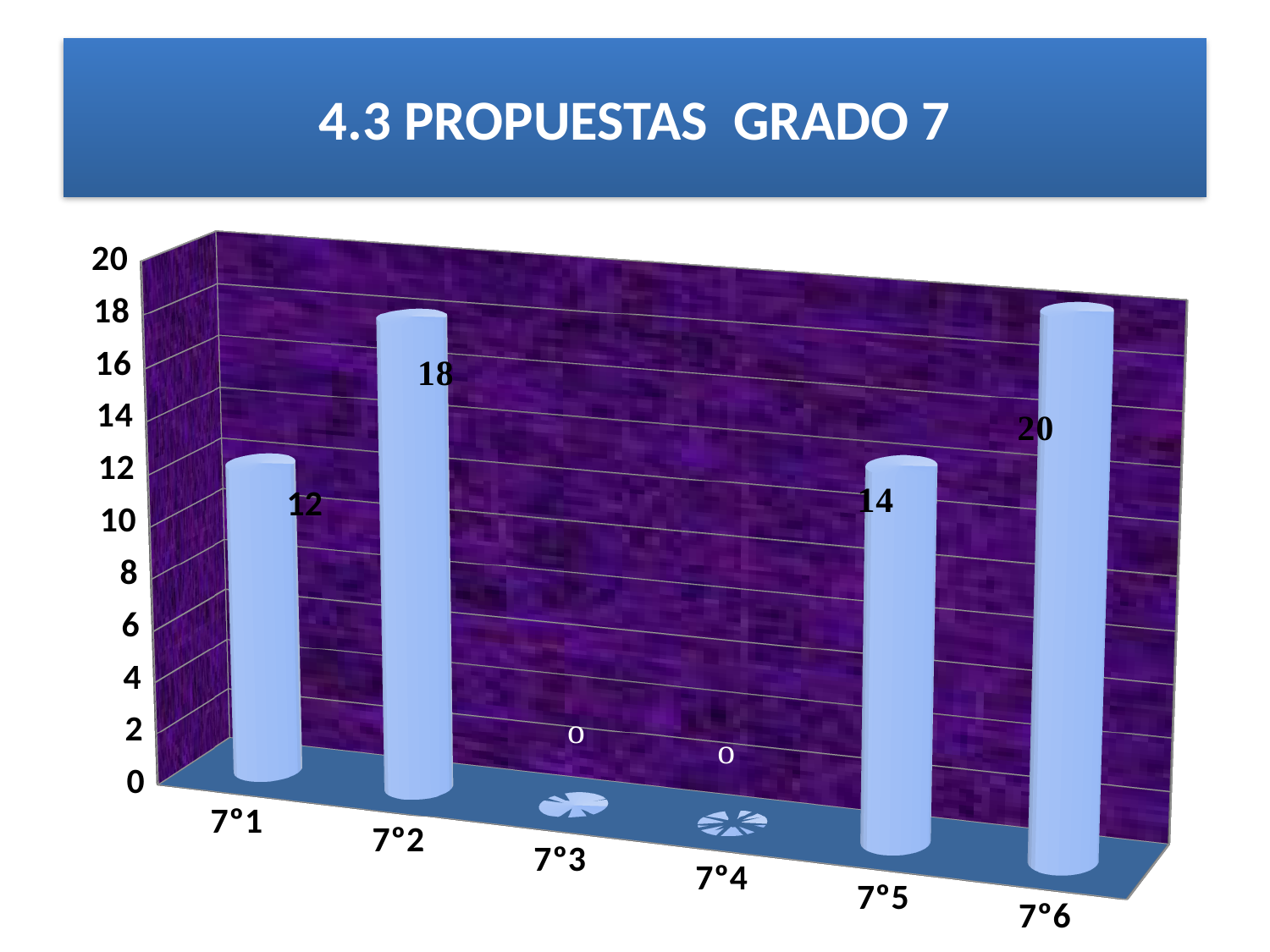
How many categories are shown on the x axis? 6 What is the title of the slide? 4.3 PROPUESTAS GRADO 7 What is the value for 7°2? 18 What is the difference between the values for 7°6 and 7°1? 8 Which category has the highest value? 7°6 Which is larger, the value for 7°2 or the value for 7°5? 7°2 What is the value for 7°5? 14 What kind of chart is shown on the slide? bar chart What is the value for 7°1? 12 What is the value for 7°6? 20 What is the value for 7°3? 0 What is the difference between the values for 7°2 and 7°5? 4